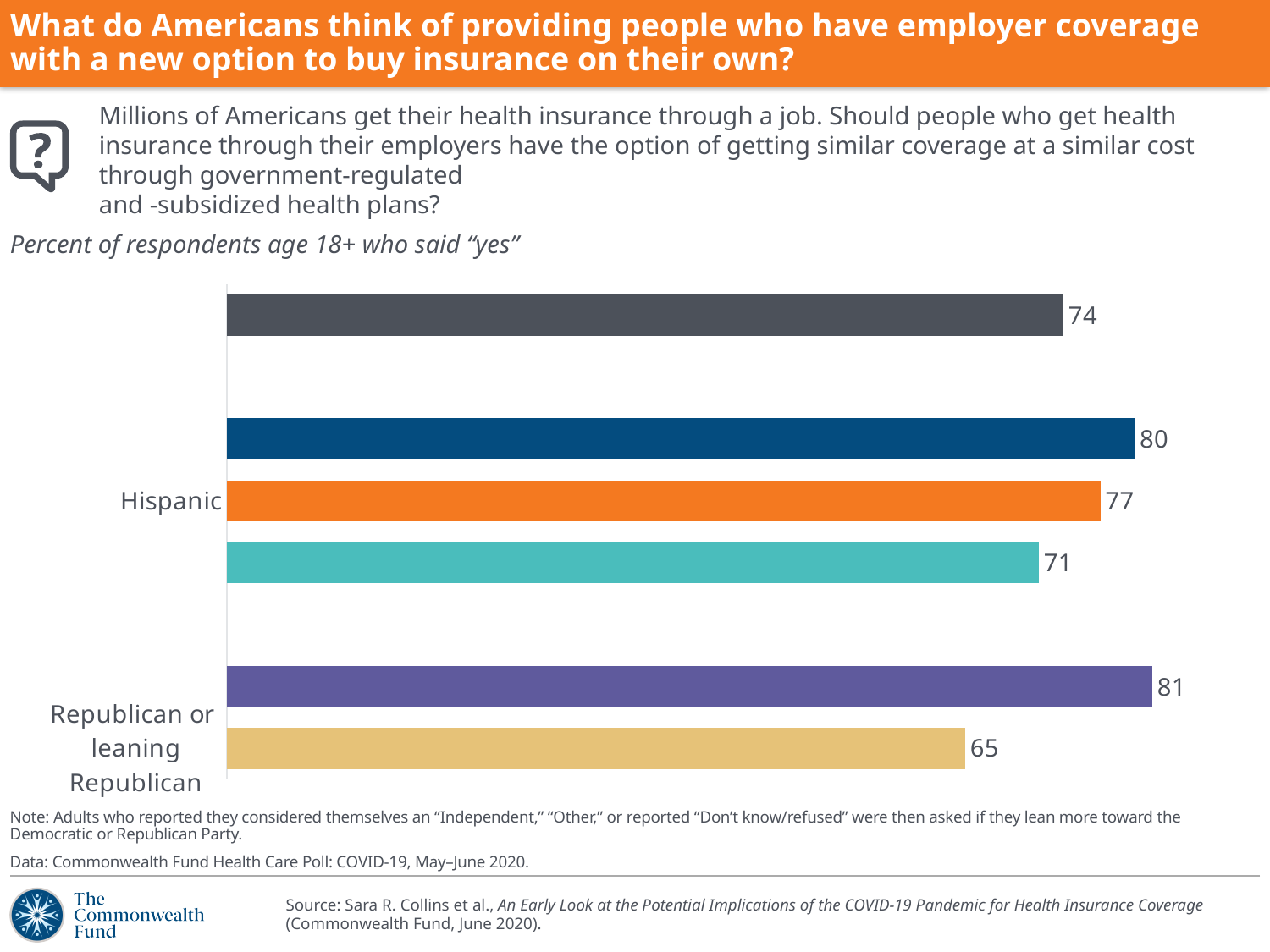
What is the difference between the Hispanic value and the Republican or leaning Republican value? 12 What kind of chart is shown on the slide? Bar chart What percent of Hispanic respondents said "yes"? 77 According to the chart subtitle, what do the values represent? Percent of respondents age 18+ who said "yes" What is the highest value shown on the chart? 81 What is the lowest value shown on the chart? 65 How many bars are shown on the chart? 6 Which is larger, the value for Hispanic or the value for Republican or leaning Republican? Hispanic What is the value for Republican or leaning Republican respondents? 65 Which group has the lowest value on the chart? Republican or leaning Republican What colour is the bar for Hispanic respondents? Orange